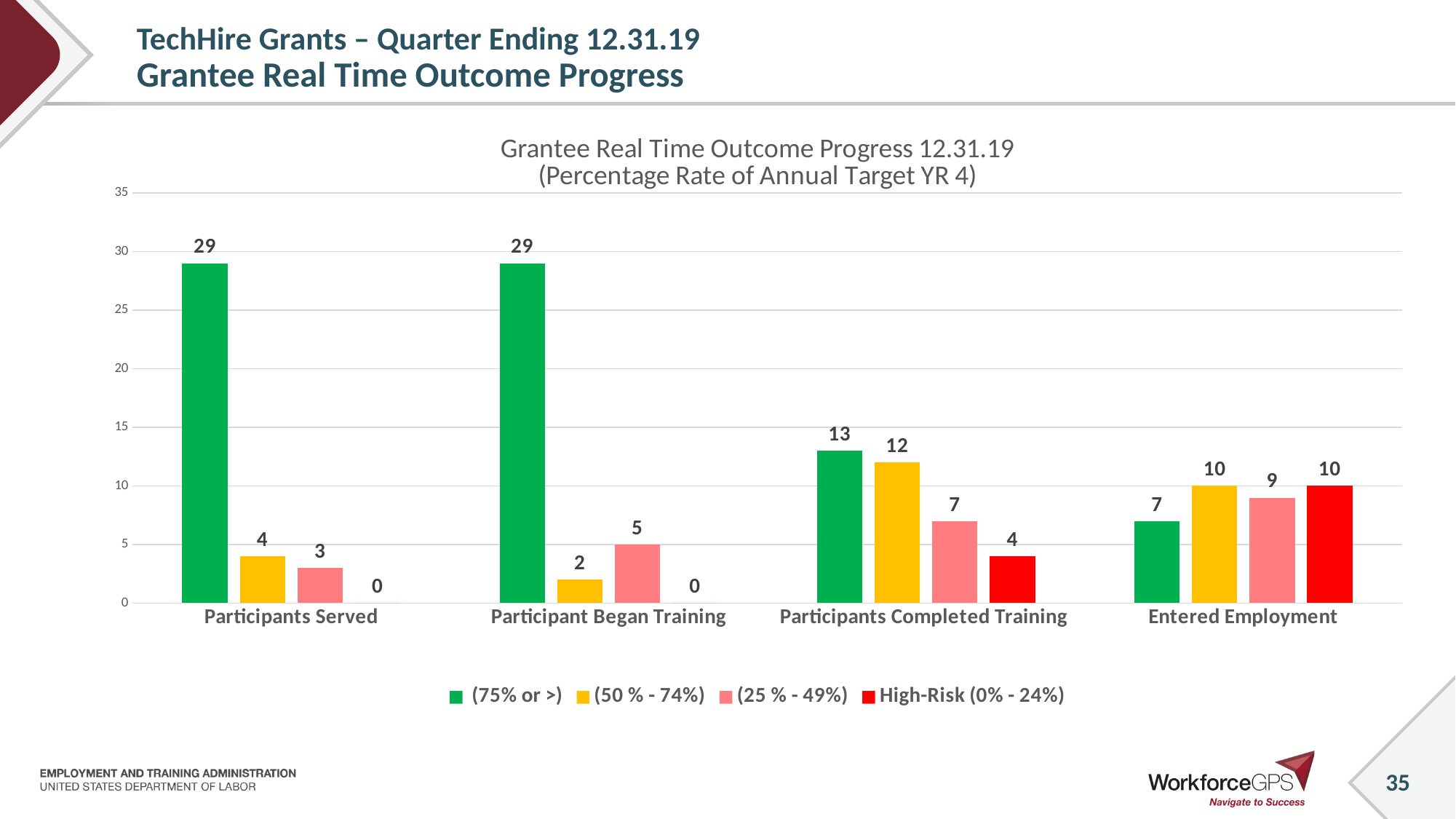
How many series does the legend list? 4 How many categories are shown on the x axis? 4 What is the value of the (50 % - 74%) series for Participant Began Training? 2 Which category has the highest value for the (50 % - 74%) series? Participants Completed Training Which category has the lowest value for the (75% or >) series? Entered Employment What is the difference between the (75% or >) value and the (50 % - 74%) value for Participants Completed Training? 1 Which is larger for Entered Employment: the (75% or >) value or the High-Risk (0% - 24%) value? High-Risk (0% - 24%) What is the value of the High-Risk (0% - 24%) series for Participants Completed Training? 4 What is the value of the (75% or >) series for Participants Served? 29 What is the title of the chart? Grantee Real Time Outcome Progress 12.31.19 (Percentage Rate of Annual Target YR 4) What is the value of the (25 % - 49%) series for Entered Employment? 9 What kind of chart is shown on the slide? Bar chart